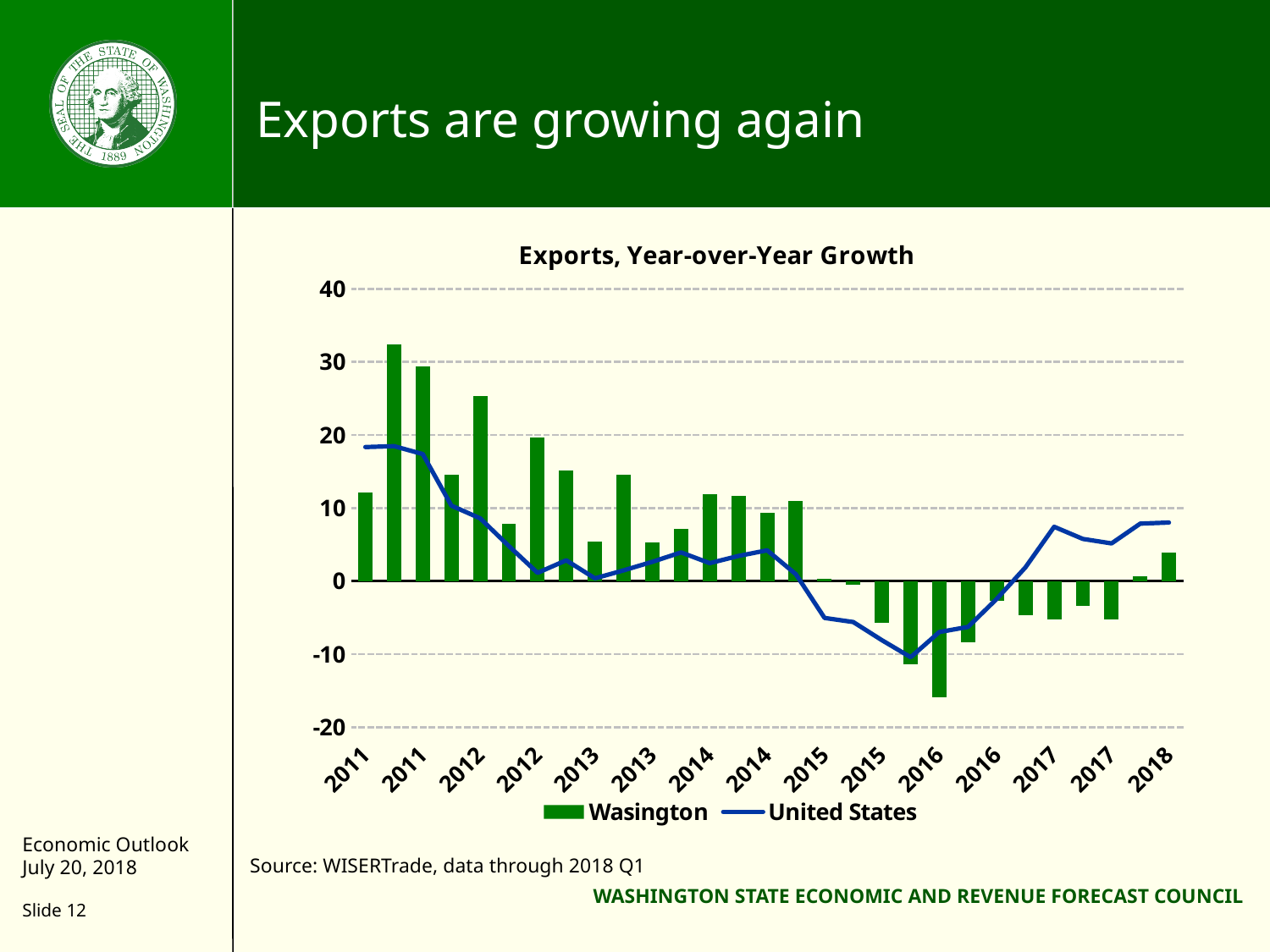
In which year does the highest Washington bar occur? 2011 At the final 2018 point, which is higher: the Washington bar or the United States line? United States Which series is drawn as a line in the chart? United States Is the tallest Washington bar greater or less than 30? greater At the lowest Washington bar in 2016, which series is lower: Washington or United States? Washington Is the United States value at the first 2011 point greater or less than 10? greater Is the lowest Washington bar (in 2016) greater or less than -10? less Do the Washington bars generally rise or fall from 2011 to 2016? fall What kind of chart is shown on the slide? Combined bar and line chart What is the title of the chart? Exports, Year-over-Year Growth How many series does the chart legend list? 2